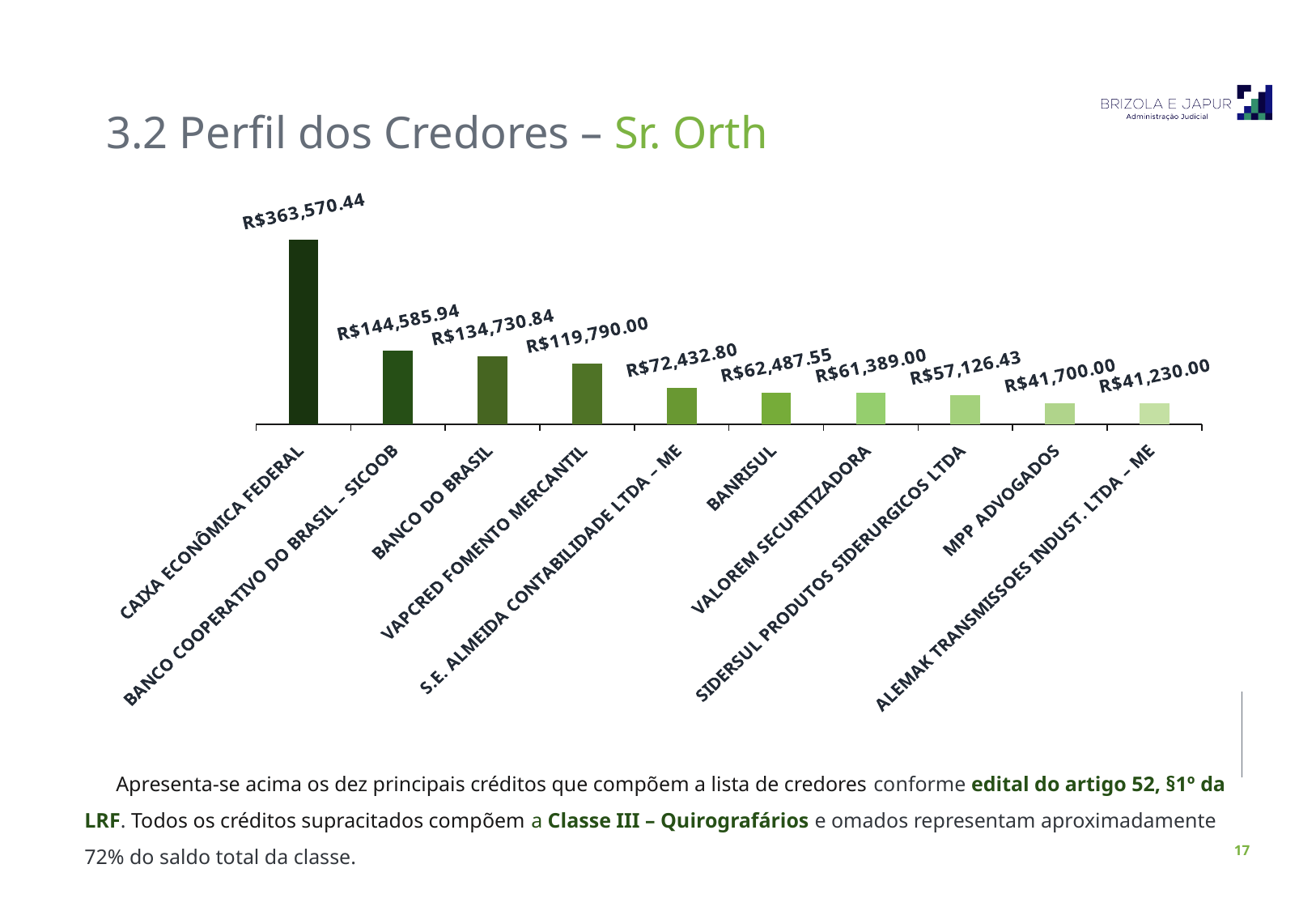
What is the value for BANRISUL? R$62,487.55 How many creditors are shown in the chart? 10 Which creditor has the highest value? CAIXA ECONÔMICA FEDERAL What is the difference between the values for CAIXA ECONÔMICA FEDERAL and BANCO COOPERATIVO DO BRASIL – SICOOB? R$218,984.50 What kind of chart is shown on the slide? Bar chart Which is larger, the value for S.E. ALMEIDA CONTABILIDADE LTDA – ME or the value for SIDERSUL PRODUTOS SIDERURGICOS LTDA? S.E. ALMEIDA CONTABILIDADE LTDA – ME What is the value for BANCO DO BRASIL? R$134,730.84 What is the difference between the values for BANCO DO BRASIL and VAPCRED FOMENTO MERCANTIL? R$14,940.84 Which creditor has the lowest value? ALEMAK TRANSMISSOES INDUST. LTDA – ME What is the value for CAIXA ECONÔMICA FEDERAL? R$363,570.44 What is the value for MPP ADVOGADOS? R$41,700.00 Do the values rise or fall from left to right along the x axis? Fall